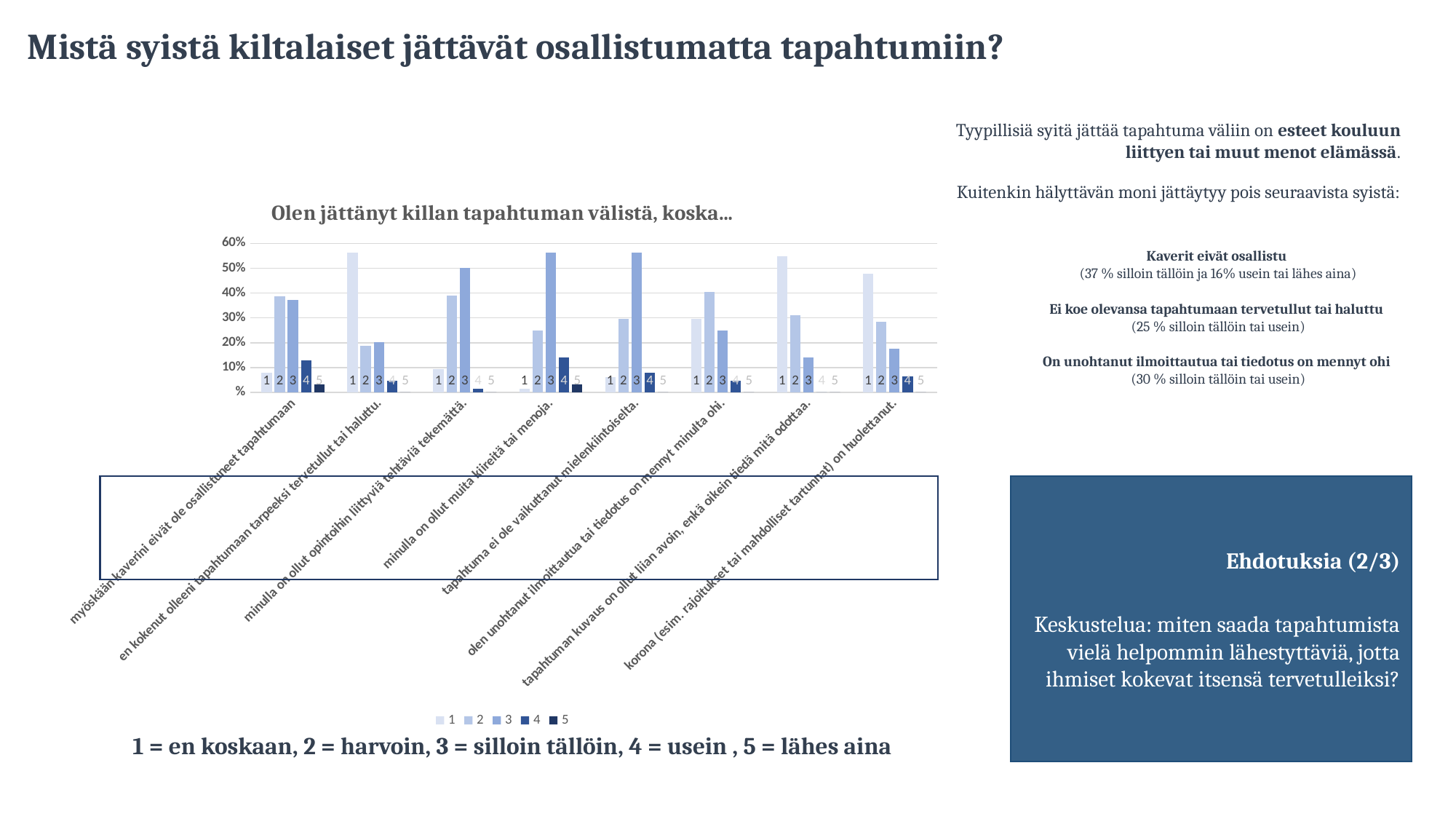
Is the value of series 3 for "minulla on ollut muita kiireitä tai menoja." greater or less than 50%? greater According to the key below the chart, what does the value 3 stand for? silloin tällöin What is the title of the chart? Olen jättänyt killan tapahtuman välistä, koska... Is the value of series 4 for "myöskään kaverini eivät ole osallistuneet tapahtumaan" greater or less than 20%? less How many categories are shown on the x axis of the chart? 8 Is the value of series 2 for "olen unohtanut ilmoittautua tai tiedotus on mennyt minulta ohi." greater or less than 30%? greater What kind of chart is shown on the slide? bar chart For "minulla on ollut opintoihin liittyviä tehtäviä tekemättä.", which is larger: the value of series 2 or series 3? series 3 How many series does the legend of the chart list? 5 Which series has the highest value for "tapahtuma ei ole vaikuttanut mielenkiintoiselta."? 3 Which series has the highest value for "korona (esim. rajoitukset tai mahdolliset tartunnat) on huolettanut."? 1